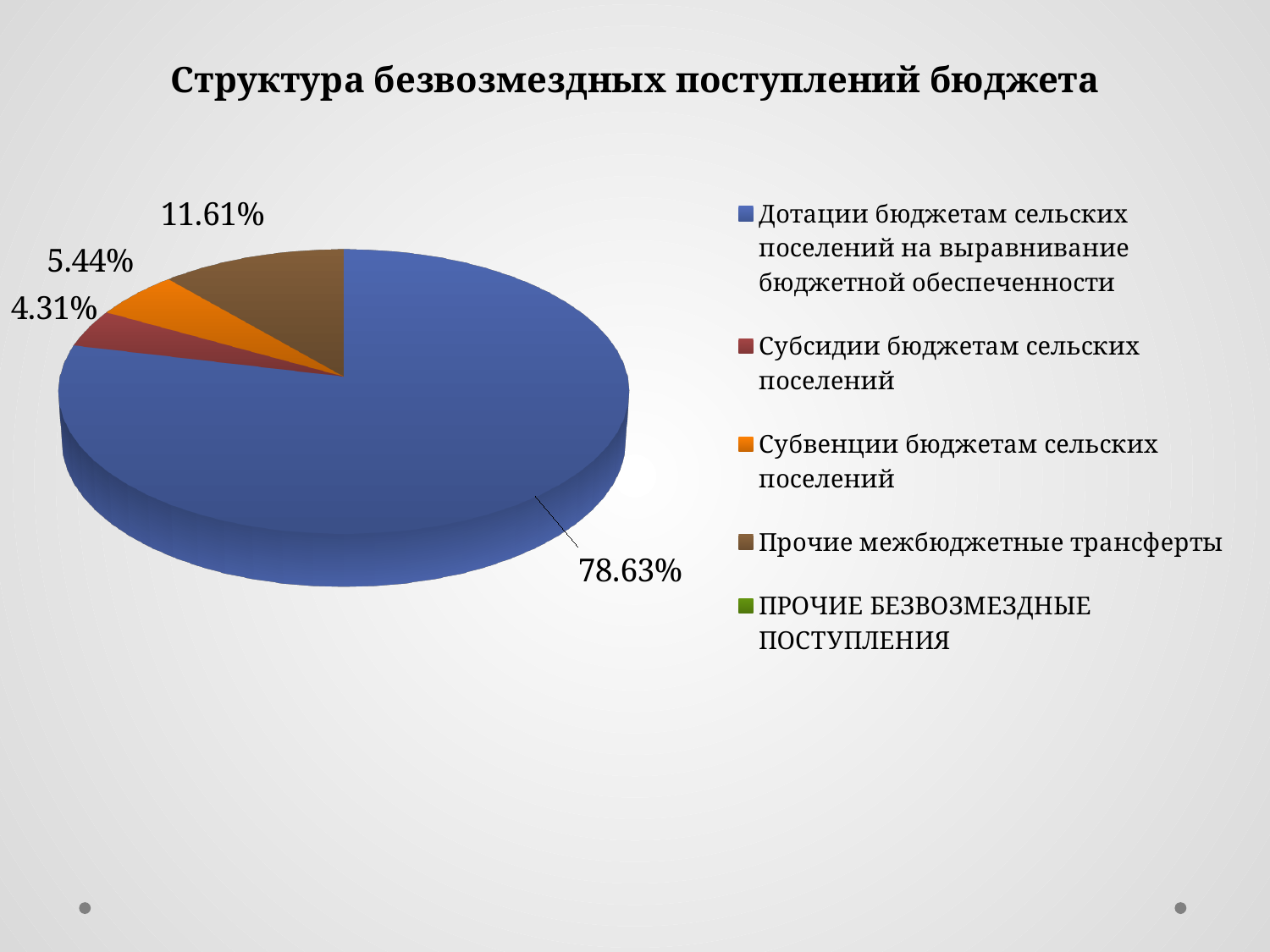
Which category has the largest slice of the pie? Дотации бюджетам сельских поселений на выравнивание бюджетной обеспеченности What share is shown for "Субвенции бюджетам сельских поселений"? 5.44% What share is shown for "Субсидии бюджетам сельских поселений"? 4.31% What colour is the slice for "Прочие межбюджетные трансферты"? Brown What kind of chart is shown on the slide? Pie chart What share is shown for "Дотации бюджетам сельских поселений на выравнивание бюджетной обеспеченности"? 78.63% What is the difference in percentage points between the share for "Дотации бюджетам сельских поселений на выравнивание бюджетной обеспеченности" and the share for "Прочие межбюджетные трансферты"? 67.02 What share is shown for "Прочие межбюджетные трансферты"? 11.61% Which is larger: the share for "Субвенции бюджетам сельских поселений" or the share for "Субсидии бюджетам сельских поселений"? Субвенции бюджетам сельских поселений What is the difference in percentage points between the share for "Субвенции бюджетам сельских поселений" and the share for "Субсидии бюджетам сельских поселений"? 1.13 What is the title of the chart? Структура безвозмездных поступлений бюджета How many entries does the legend list? 5